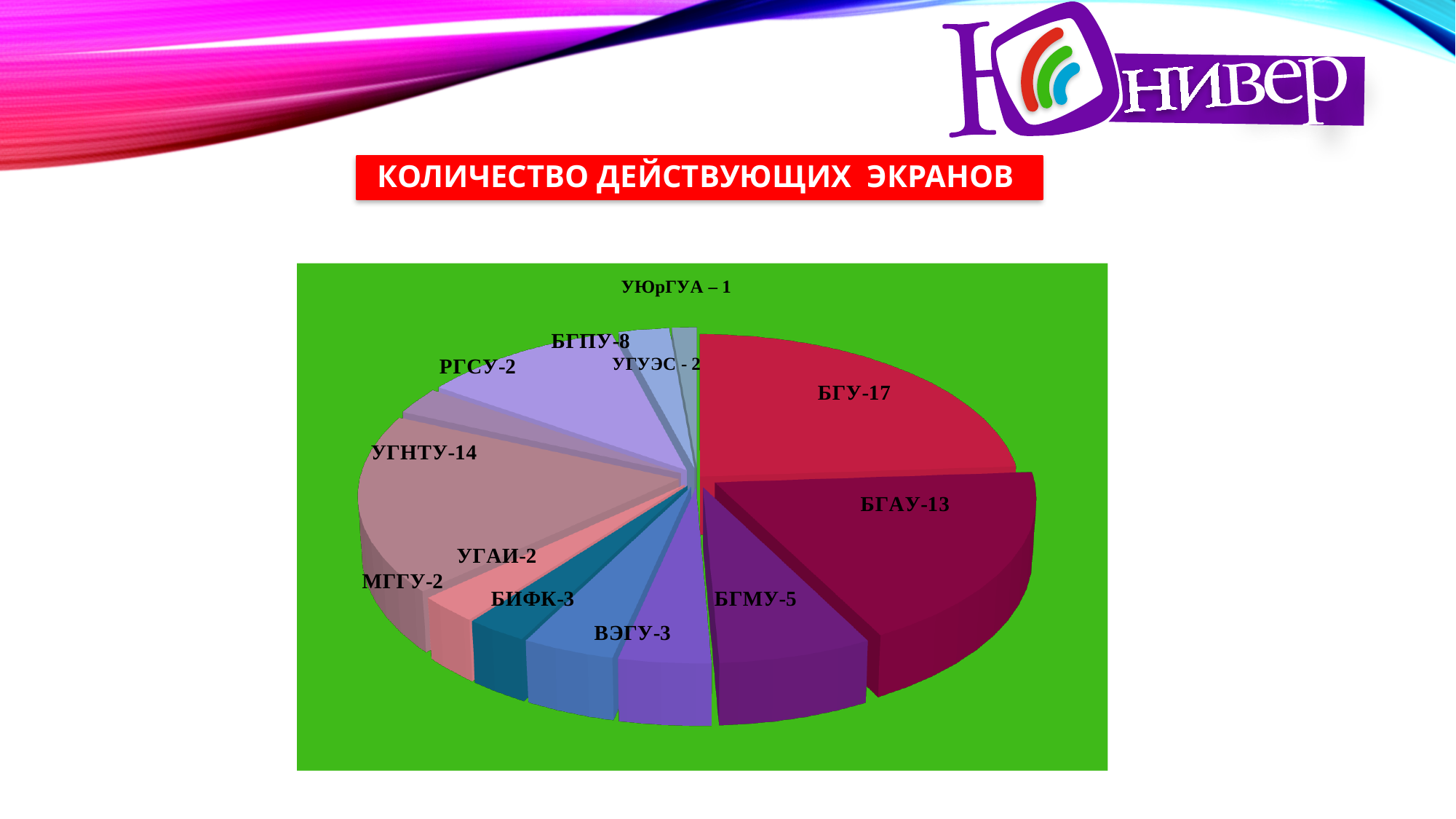
What value is labelled for БГПУ on the pie chart? 8 What is the difference between the values for УГНТУ and БГМУ? 9 Which is larger, the value for БГМУ or the value for ВЭГУ? БГМУ Which category has the smallest value in the pie chart? УЮрГУА How many categories are shown in the pie chart? 12 What type of chart is shown on the slide? Pie chart What is the title shown above the chart? КОЛИЧЕСТВО ДЕЙСТВУЮЩИХ ЭКРАНОВ Which category has the largest slice of the pie chart? БГУ How many screens does БГУ have according to the pie chart? 17 What is the difference between the values for БГУ and БГАУ? 4 Which is larger, the value for БГАУ or the value for БГПУ? БГАУ What is the value shown for УГНТУ in the pie chart? 14